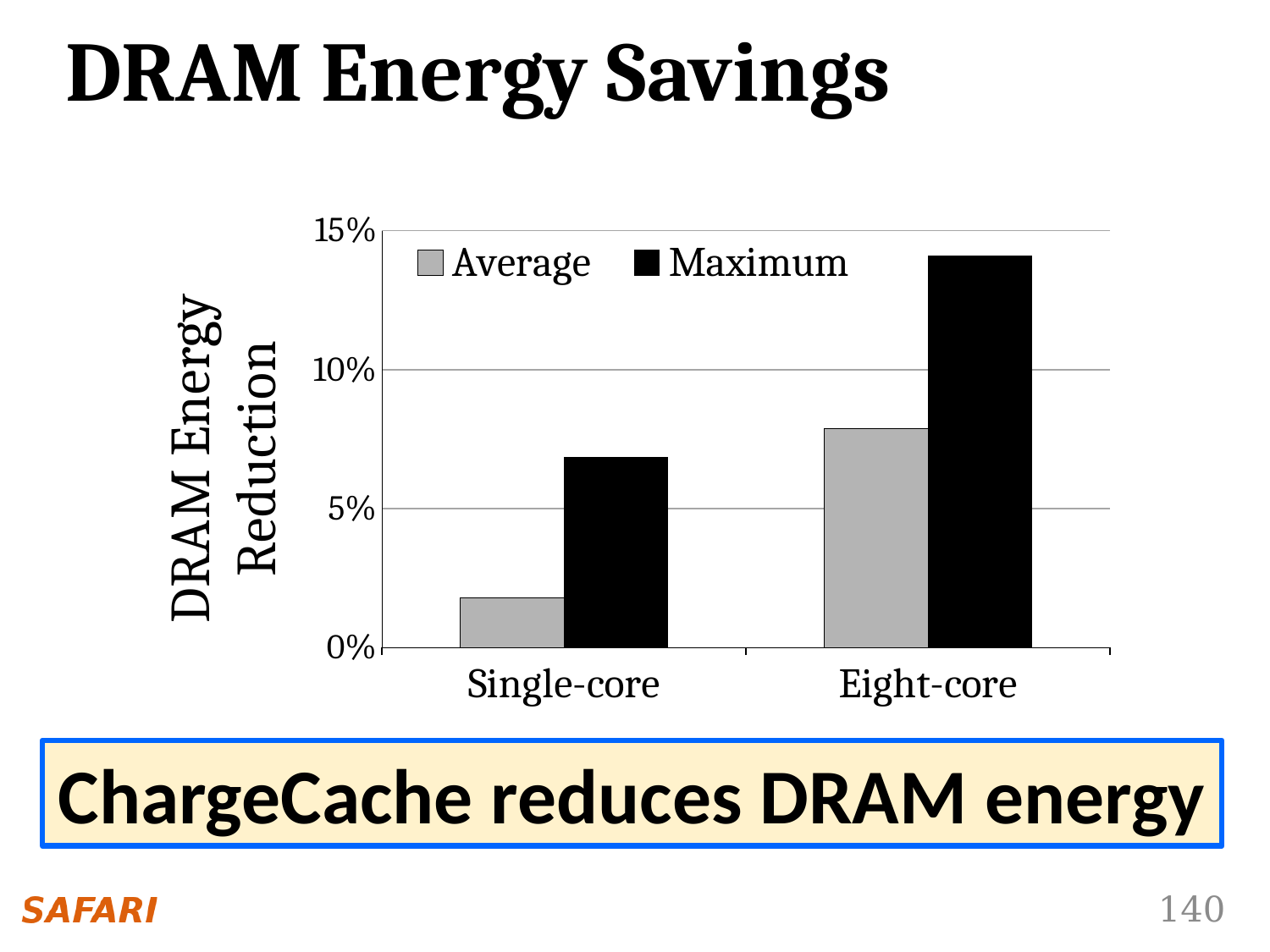
Is the Maximum value for Single-core greater or less than 5%? greater What is the label on the vertical axis of the chart? DRAM Energy Reduction Is the Maximum value for Eight-core greater or less than 10%? greater Which is larger, the Maximum value for Single-core or the Maximum value for Eight-core? Eight-core What kind of chart is shown on the slide? bar chart How many categories are shown on the x axis? 2 How many series does the legend list? 2 Is the Average value for Single-core greater or less than 5%? less Do the Average values rise or fall from Single-core to Eight-core? rise Which category has the highest Maximum DRAM energy reduction? Eight-core Which category has the lowest Average DRAM energy reduction? Single-core